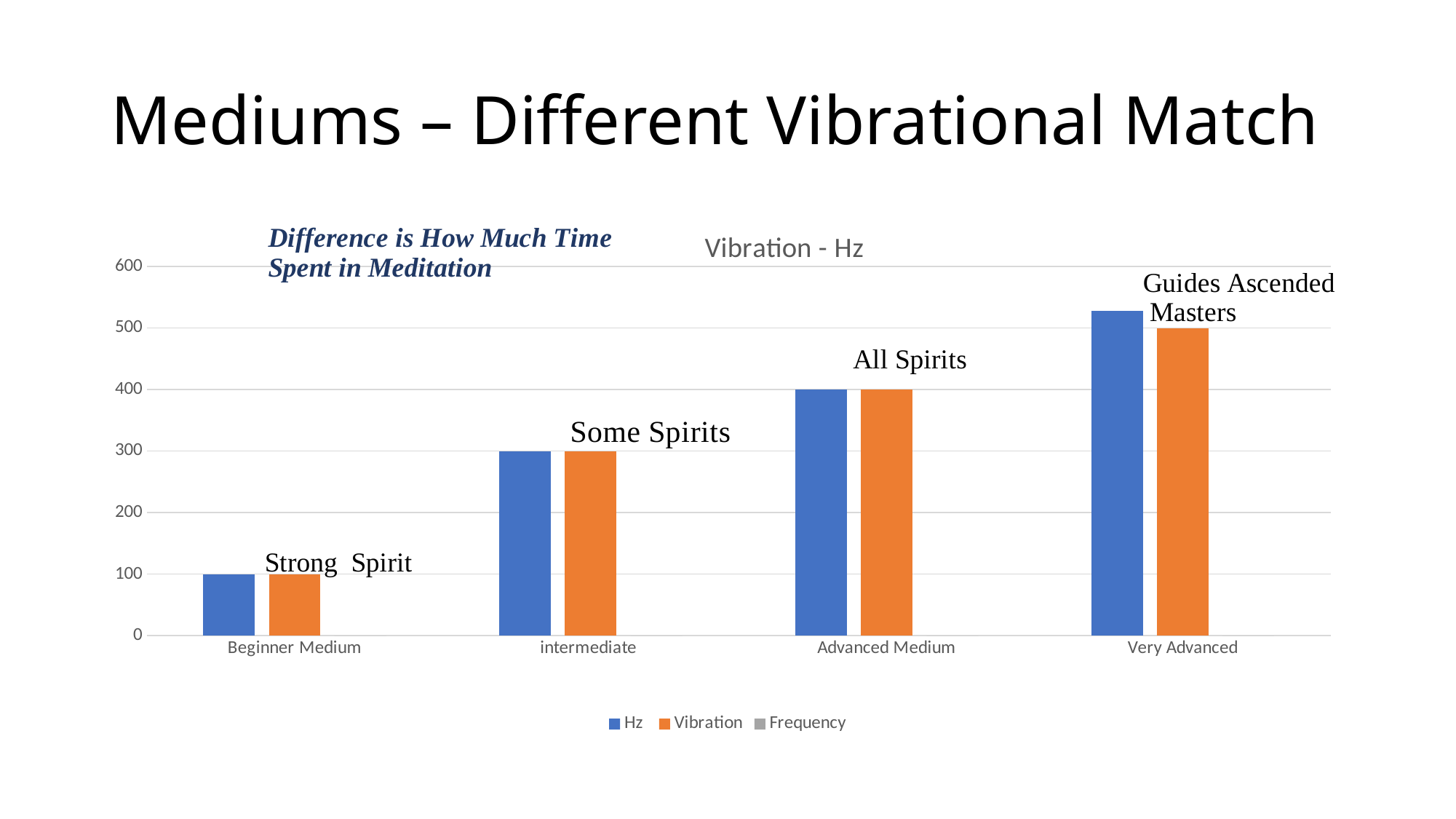
What is the difference between the Hz value for Advanced Medium and the Hz value for intermediate? 100 What is the Hz value for Beginner Medium? 100 Is the Hz value for Very Advanced greater or less than 500? greater Which category has the lowest Vibration value? Beginner Medium Do the Hz values rise or fall from Beginner Medium to Very Advanced? rise How many categories are shown on the x axis of the chart? 4 What kind of chart is shown on the slide? bar chart What is the Vibration value for intermediate? 300 What is the title of the chart? Vibration - Hz How many series does the chart's legend list? 3 What is the Hz value for Advanced Medium? 400 Which category has the highest Hz value? Very Advanced